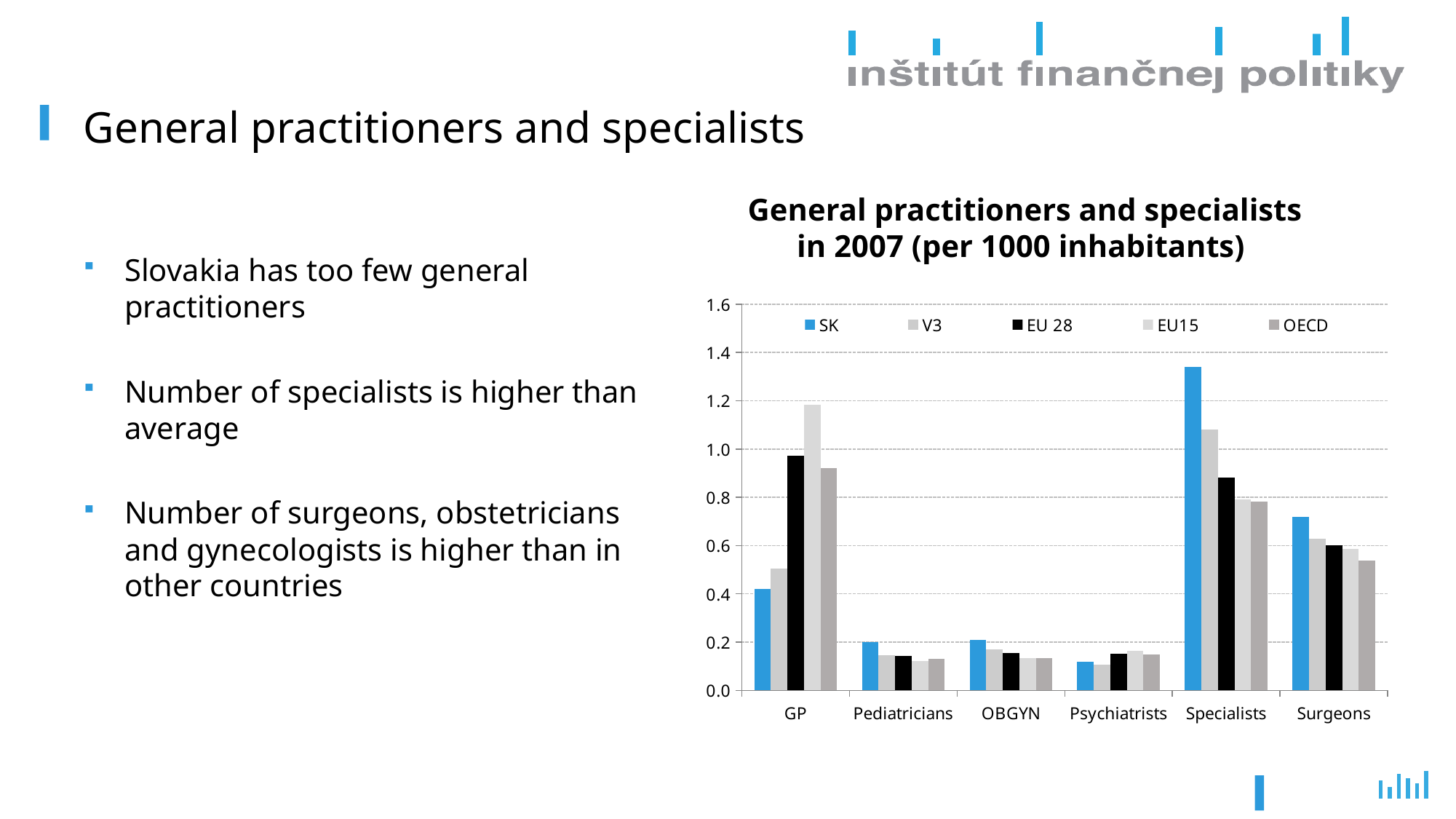
How many categories are shown on the x axis of the chart? 6 For the GP category, which series has the lowest value? SK What kind of chart is shown on the slide? bar chart Is the SK value for Specialists greater or less than 1.2? greater Is the SK value for GP greater or less than 0.6? less What is the title of the chart? General practitioners and specialists in 2007 (per 1000 inhabitants) Is the EU15 value for GP greater or less than 1.0? greater For the Surgeons category, which is larger: the SK value or the OECD value? SK For the Specialists category, which series has the highest value? SK Which category has the highest value for the SK series? Specialists For the GP category, which is larger: the SK value or the EU 28 value? EU 28 How many series does the chart legend list? 5